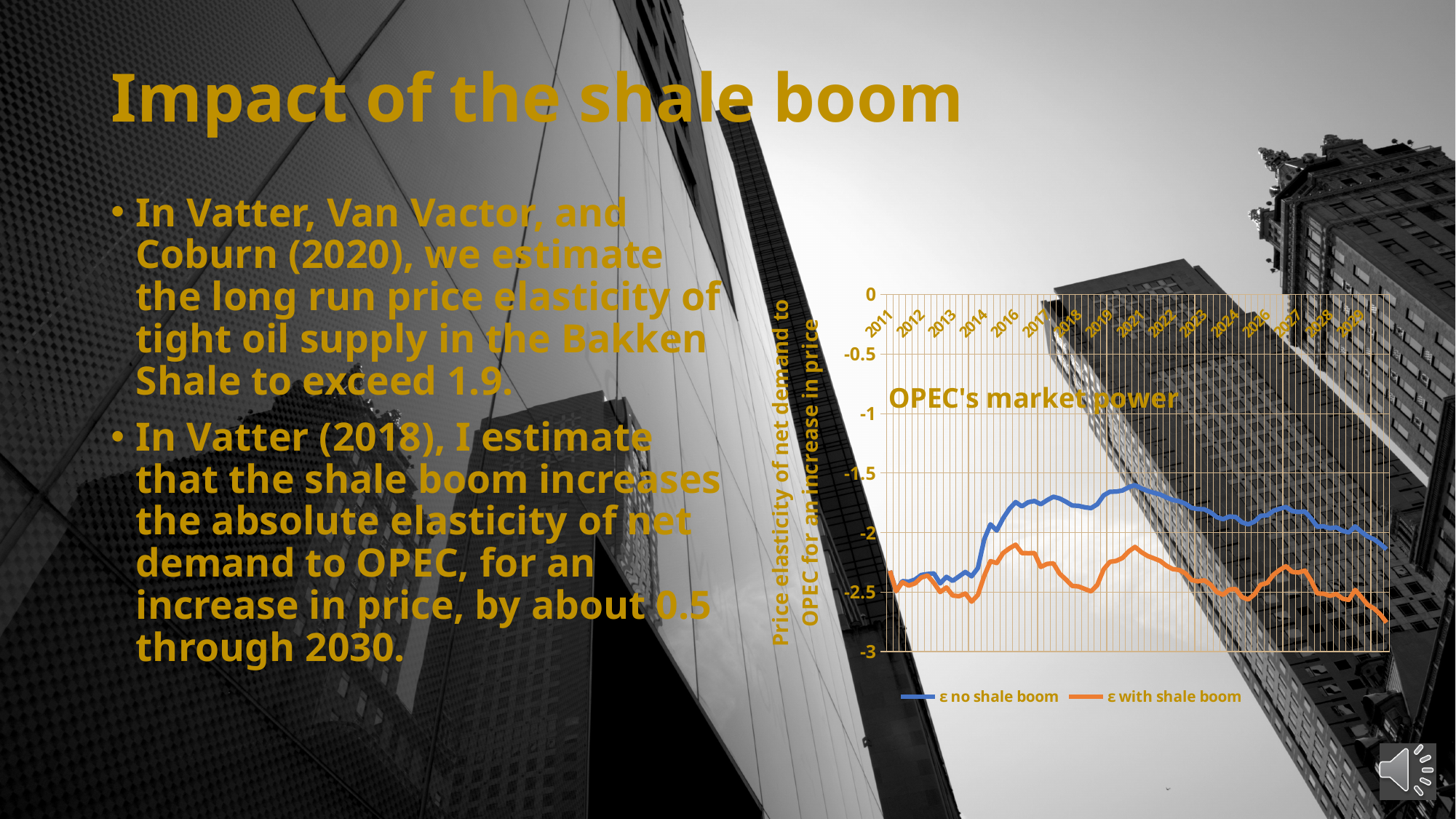
How many series does the chart's legend list? 2 Which series is drawn in orange in the chart? ε with shale boom Is the value of the 'ε no shale boom' series in 2021 greater or less than -2? greater Which series lies below the other across the whole chart? ε with shale boom Is the value of the 'ε with shale boom' series in 2021 greater or less than -2.5? greater What is the lowest tick value shown on the chart's vertical axis? -3 What is the title of the chart? OPEC's market power What kind of chart is shown on the slide? line chart Which series has the higher value in 2026, 'ε no shale boom' or 'ε with shale boom'? ε no shale boom Do the values of the 'ε no shale boom' series rise or fall from 2021 to 2029? fall Is the value of the 'ε no shale boom' series in 2011 greater or less than -2? less